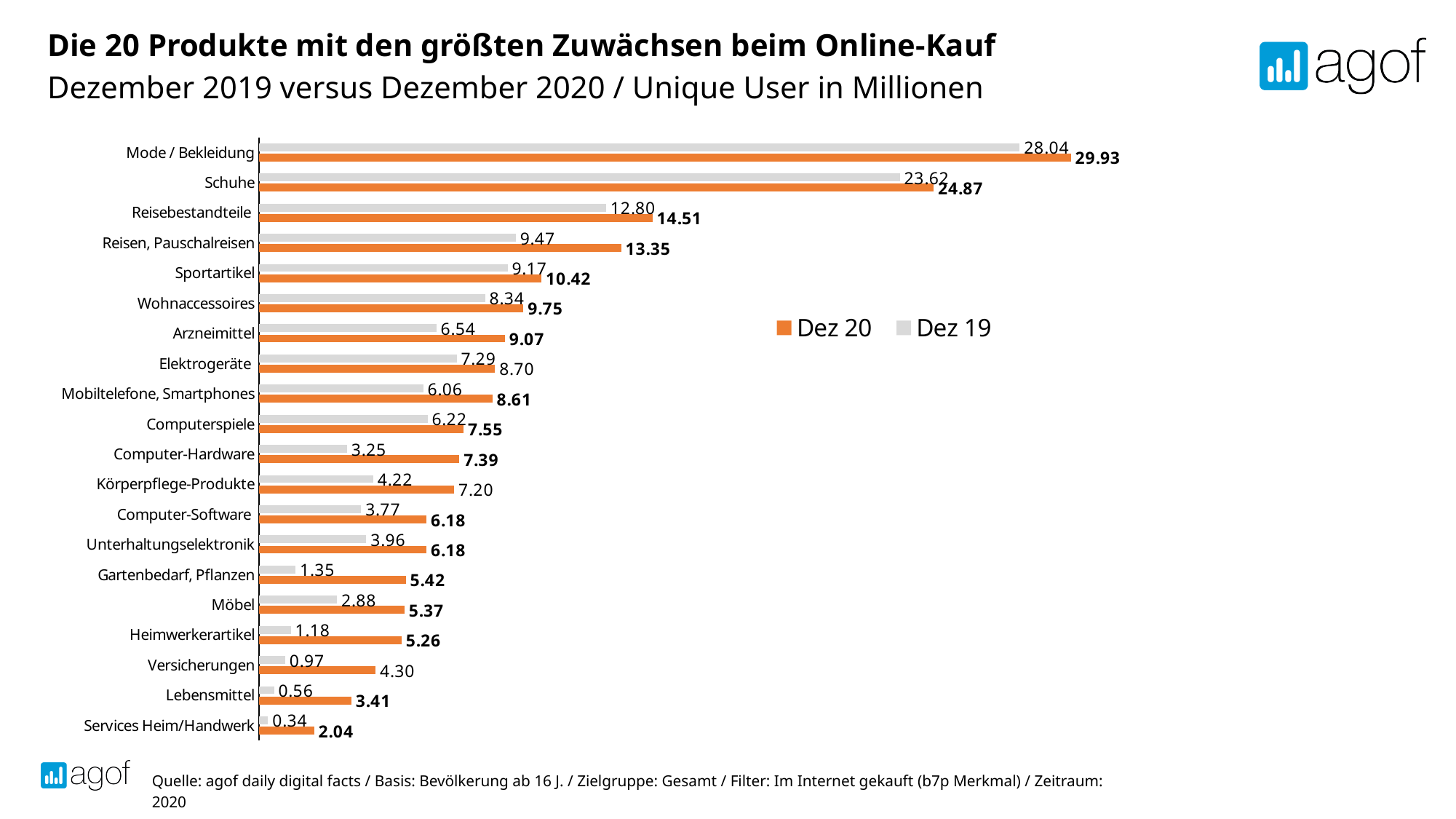
What is the Dez 20 value for Gartenbedarf, Pflanzen? 5.42 Which category has the highest Dez 20 value? Mode / Bekleidung What is the difference between the Dez 20 and Dez 19 values for Reisebestandteile? 1.71 Which colour represents the Dez 20 series? Orange What is the difference between the Dez 20 and Dez 19 values for Computer-Hardware? 4.14 What is the Dez 19 value for Schuhe? 23.62 How many product categories are shown in the chart? 20 Which is larger: the Dez 19 value for Elektrogeräte or the Dez 19 value for Arzneimittel? Elektrogeräte How many series does the legend list? 2 Which category has the lowest Dez 19 value? Services Heim/Handwerk What is the Dez 20 value for Mode / Bekleidung? 29.93 What kind of chart is shown on the slide? Bar chart